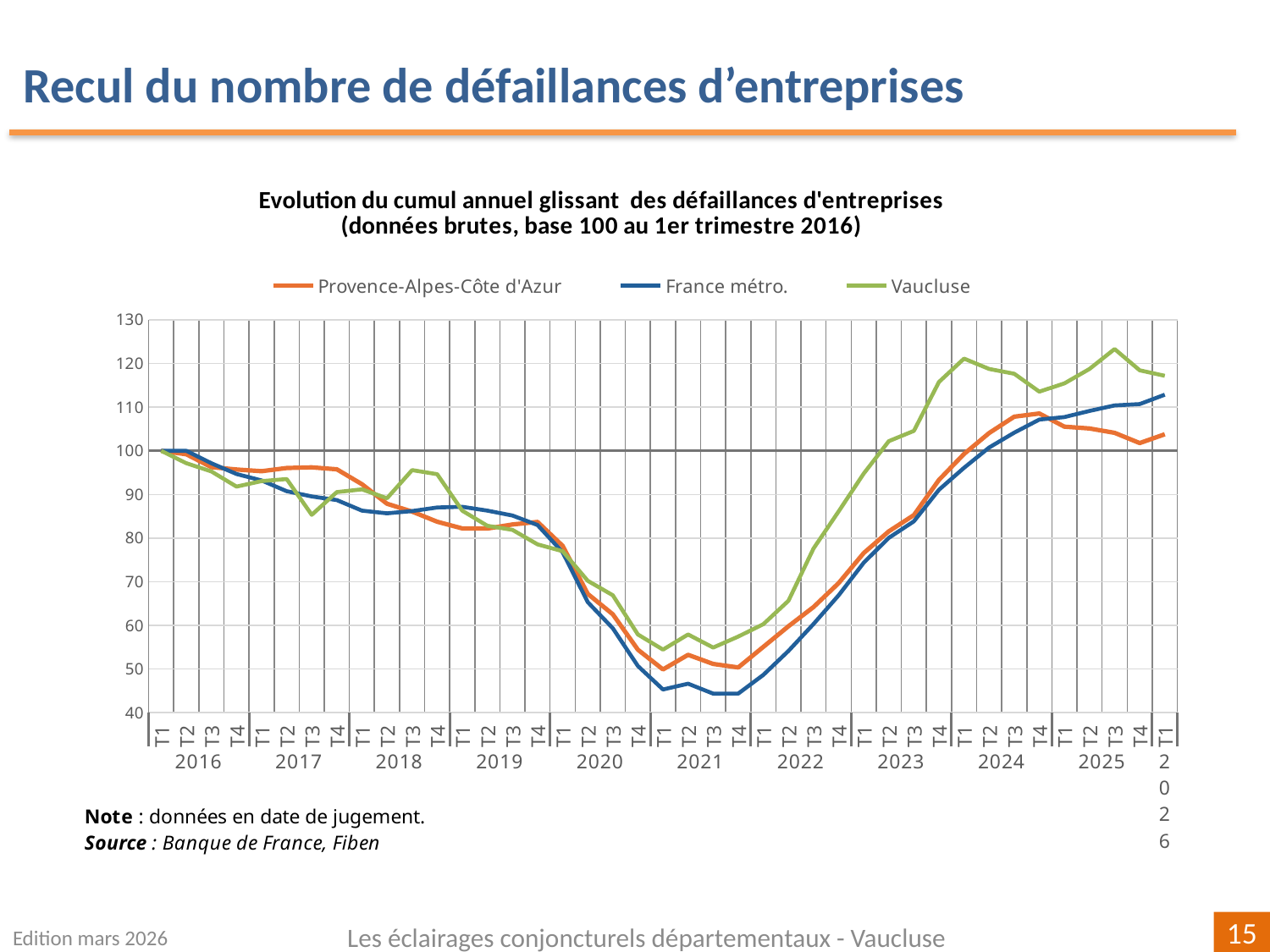
Which series has the lowest value at T4 2021? France métro. What is the value of all three series at T1 2016? 100 At T1 2021, which is higher: Vaucluse or France métro.? Vaucluse Does the France métro. series rise or fall between T1 2022 and T1 2026? Rise Is the value for Vaucluse at T3 2025 greater or less than 120? greater Is the value for France métro. at T4 2021 greater or less than 50? less What kind of chart is shown on the slide? Line chart Is the value for France métro. at T1 2026 greater or less than 110? greater How many series does the legend list? 3 Which series has the highest value at T1 2026? Vaucluse Which series is drawn in green? Vaucluse